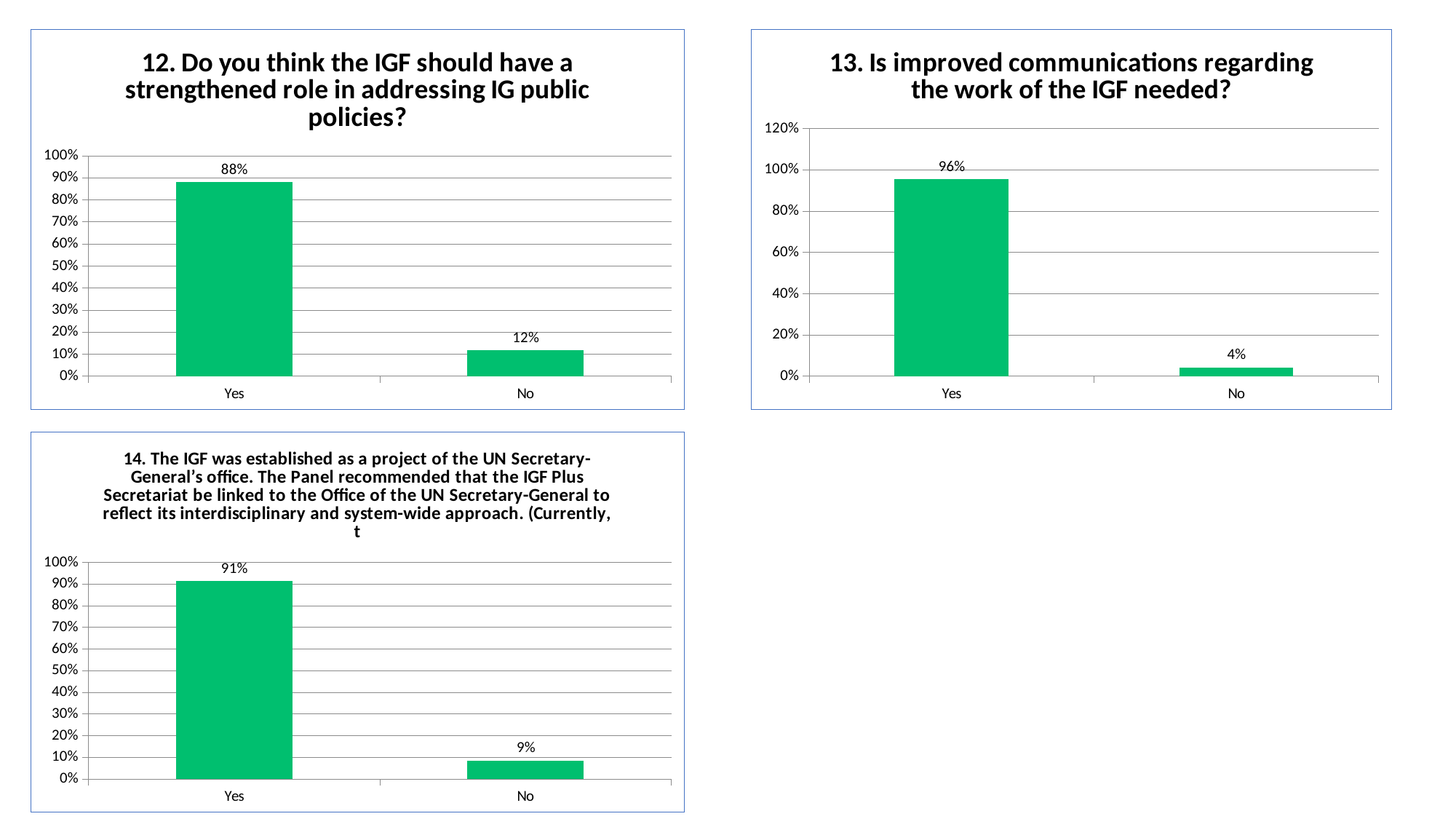
In the chart titled "13. Is improved communications regarding the work of the IGF needed?", what is the difference between the Yes and No values? 92% In the chart titled "12. Do you think the IGF should have a strengthened role in addressing IG public policies?", which category has the highest value? Yes In the bottom-left chart (question 14), which category has the lowest value? No What type of chart is the chart titled "12. Do you think the IGF should have a strengthened role in addressing IG public policies?"? Bar chart How many categories are shown in the chart titled "13. Is improved communications regarding the work of the IGF needed?"? 2 In the bottom-left chart (question 14), what is the difference between the Yes and No values? 82% In the chart titled "13. Is improved communications regarding the work of the IGF needed?", what is the value for No? 4% In the chart titled "12. Do you think the IGF should have a strengthened role in addressing IG public policies?", what is the value for Yes? 88% In the chart titled "13. Is improved communications regarding the work of the IGF needed?", what is the value for Yes? 96% In the bottom-left chart (question 14), what is the value for Yes? 91% In the bottom-left chart (question 14), what is the value for No? 9% In the chart titled "12. Do you think the IGF should have a strengthened role in addressing IG public policies?", what is the value for No? 12%